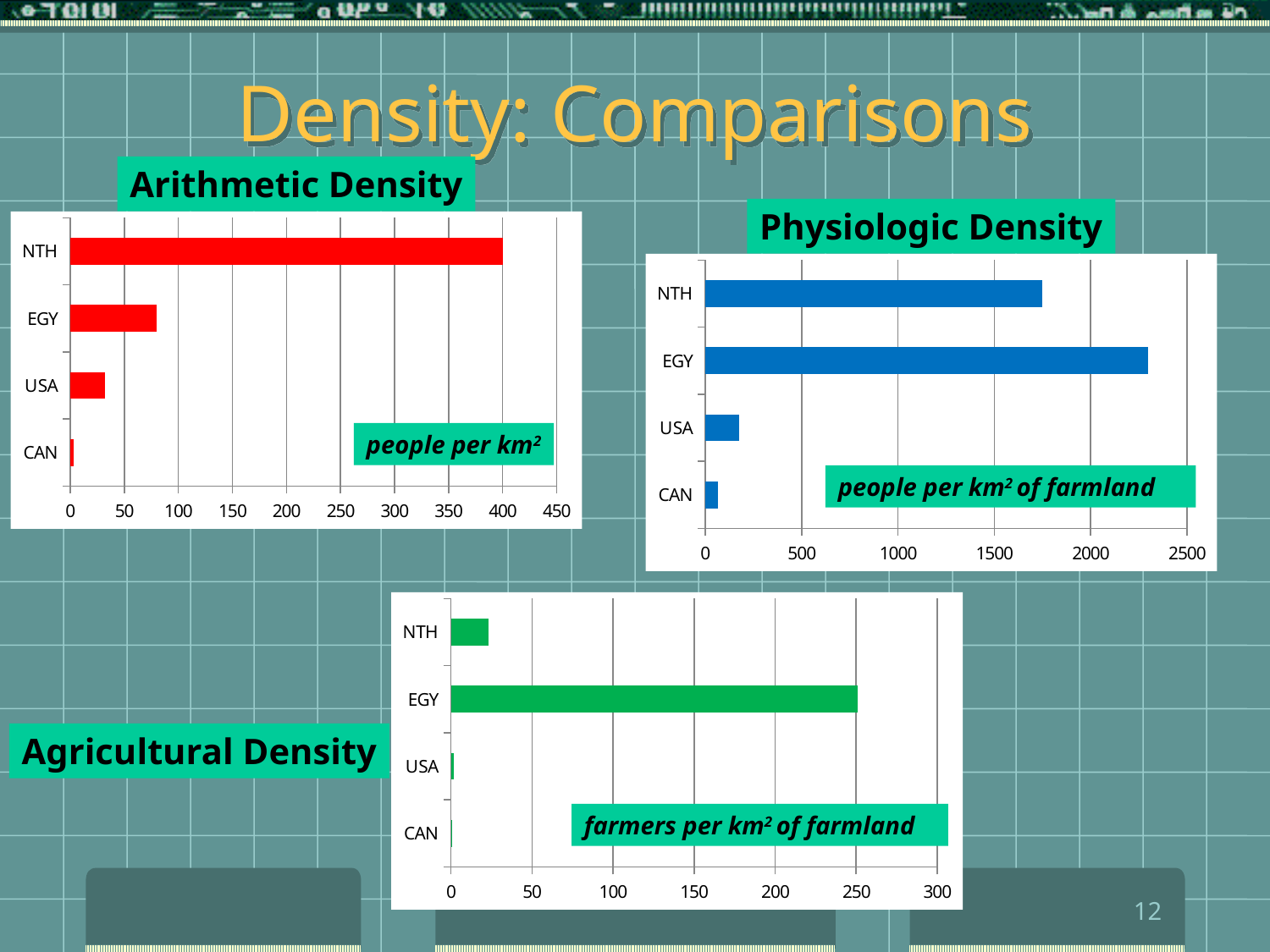
How many countries are shown in the Agricultural Density chart? 4 What kind of chart is the Physiologic Density chart? bar chart In the Arithmetic Density chart, is the value for EGY greater or less than 100? less In the Arithmetic Density chart, which country has the lowest value? CAN In the Physiologic Density chart, which country has the highest value? EGY In the Physiologic Density chart, which country has the lowest value? CAN In the Physiologic Density chart, is the value for NTH greater or less than 1500? greater In the Physiologic Density chart, which is larger, the value for USA or the value for CAN? USA In the Arithmetic Density chart, what is the value for NTH? 400 In the Arithmetic Density chart, which country has the highest value? NTH In the Agricultural Density chart, which country has the highest value? EGY